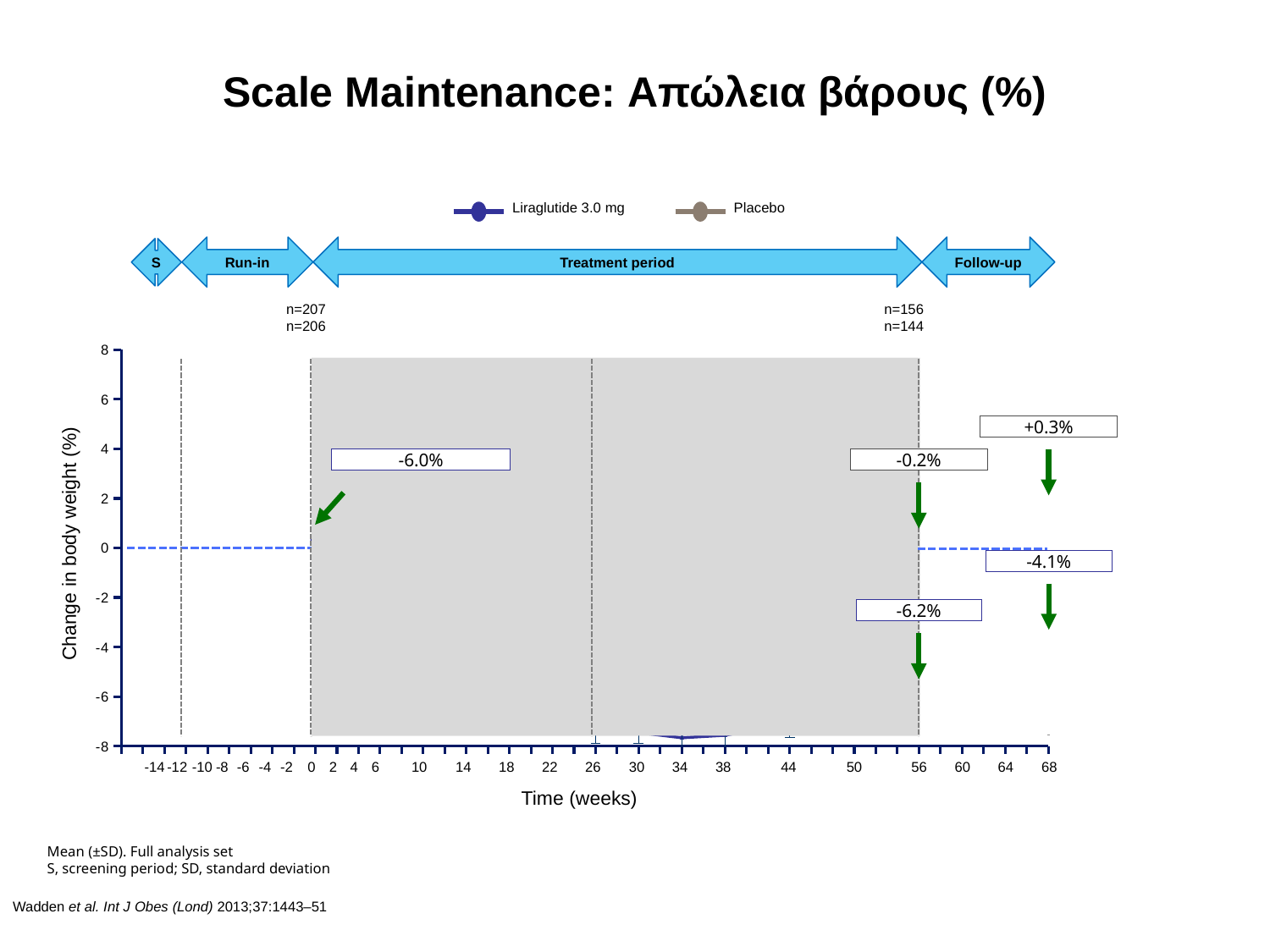
What kind of chart is shown on the slide? Line chart What is the upper annotated percentage change at week 56 on the chart? -0.2% What is the title of the chart's y axis? Change in body weight (%) What is the highest value shown on the chart's y axis? 8 What is the lower annotated percentage change at week 68 on the chart? -4.1% What are the two series named in the chart legend? Liraglutide 3.0 mg and Placebo What is the difference between the two annotated percentage changes at week 56? 6.0% Which of the two annotated values at week 68 is larger, +0.3% or -4.1%? +0.3% How many series does the chart legend list? 2 What is the upper annotated percentage change at week 68 on the chart? +0.3% What is the lower annotated percentage change at week 56 on the chart? -6.2% What percentage change is annotated at week 0 on the chart? -6.0%